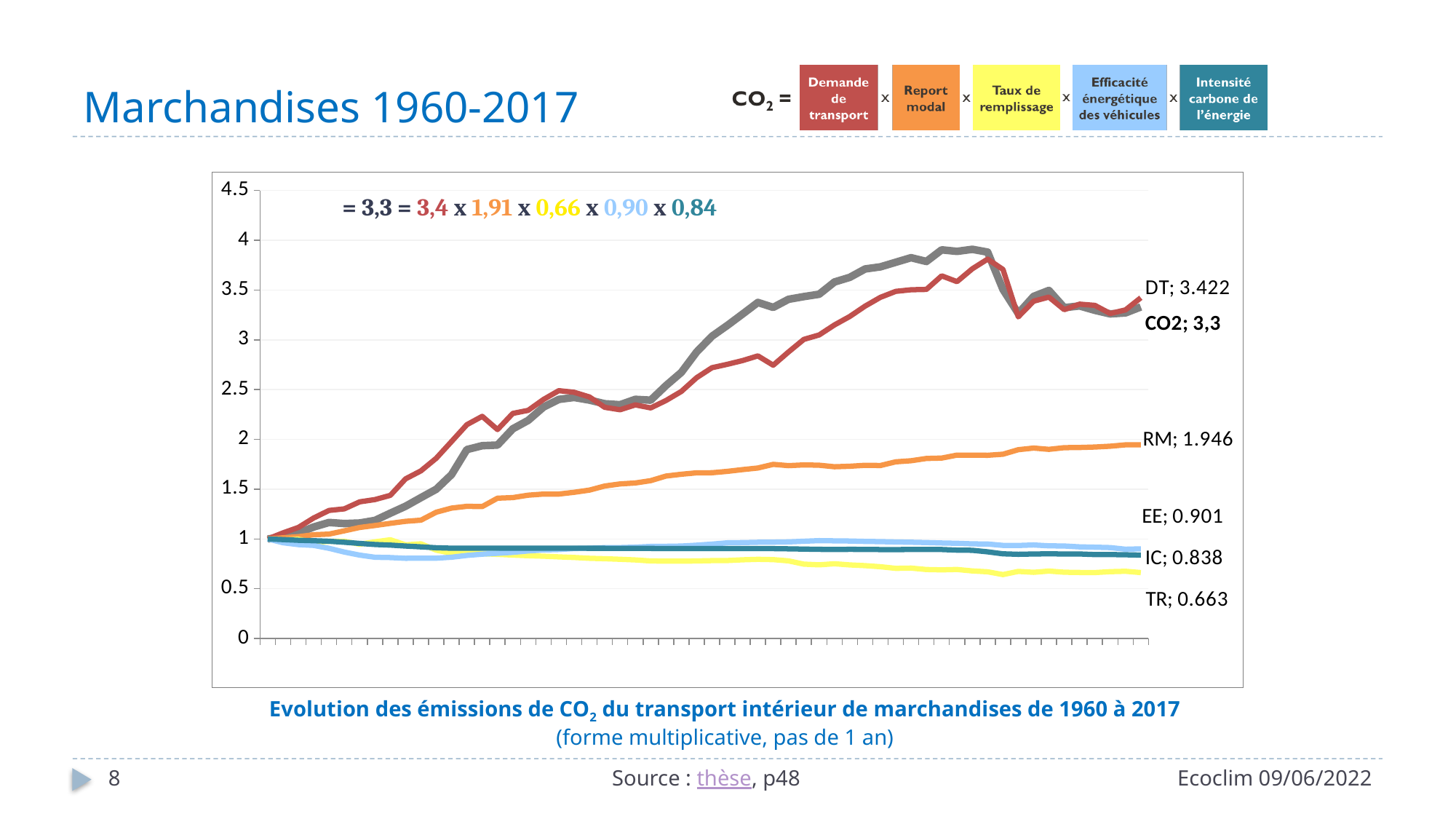
What is the final value labelled for the IC series? 0.838 How many series are plotted on the chart? 6 What is the final value labelled for the EE series? 0.901 Which series has the lowest labelled final value? TR What kind of chart is shown on the slide? line chart Which is larger at the end of the period, the RM value or the EE value? RM What is the difference between the final labelled values of EE and IC? 0.063 Does the RM series rise or fall over the period from 1960 to 2017? rise What is the final value labelled for the DT series? 3.422 What is the final value labelled for the TR series? 0.663 What is the final value labelled for the RM series? 1.946 Which series has the highest labelled final value? DT